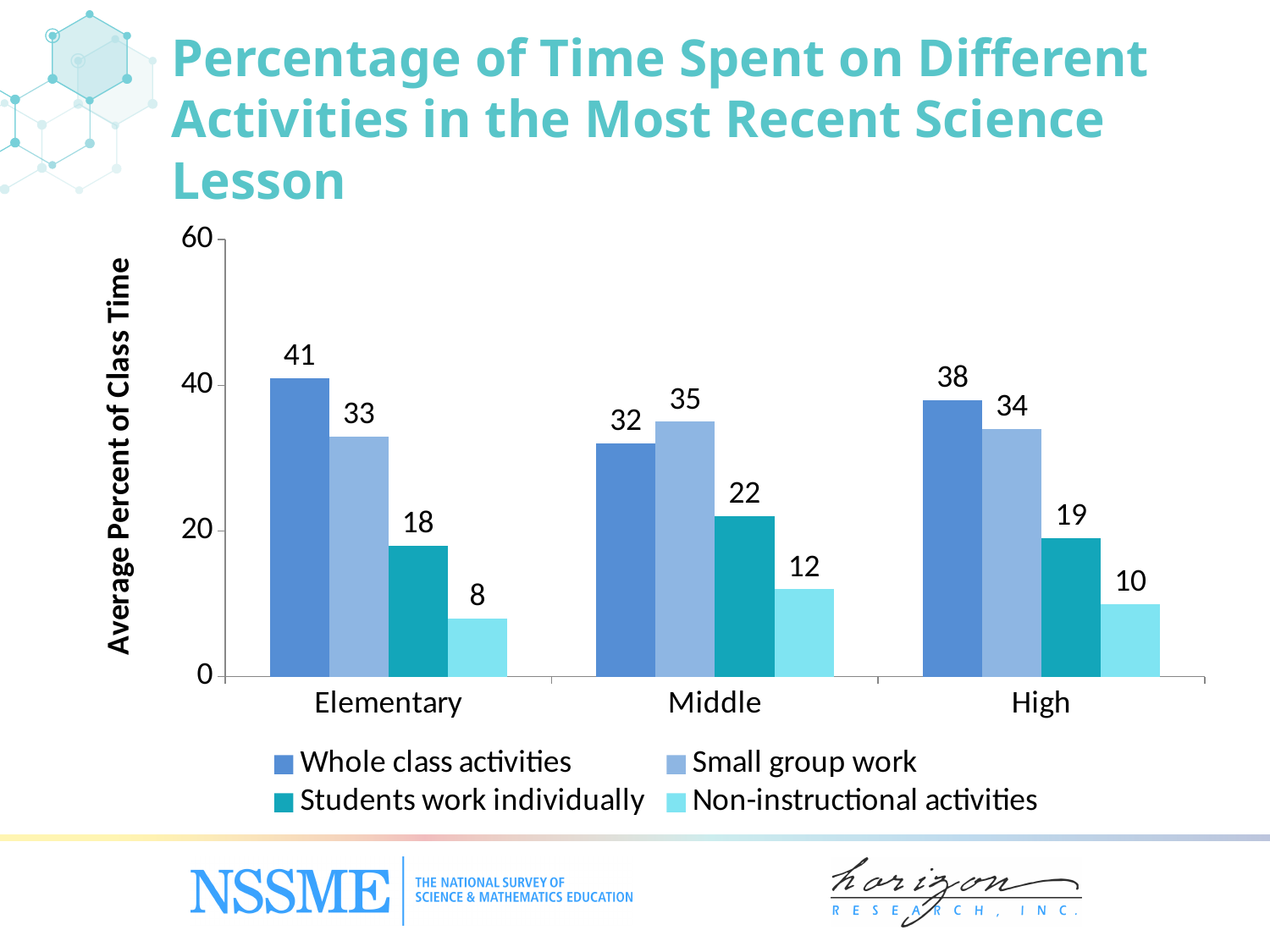
How many grade-level categories are shown on the x axis? 3 What is the difference between Whole class activities and Small group work in High? 4 What kind of chart is shown on the slide? Bar chart Which is larger in Middle: Whole class activities or Small group work? Small group work Which grade level has the lowest value for Non-instructional activities? Elementary What is the label of the vertical axis? Average Percent of Class Time What is the value for Whole class activities in Elementary? 41 Which grade level has the highest value for Whole class activities? Elementary What is the value for Students work individually in Middle? 22 What is the value for Non-instructional activities in High? 10 How many series does the legend list? 4 What is the value for Small group work in Middle? 35